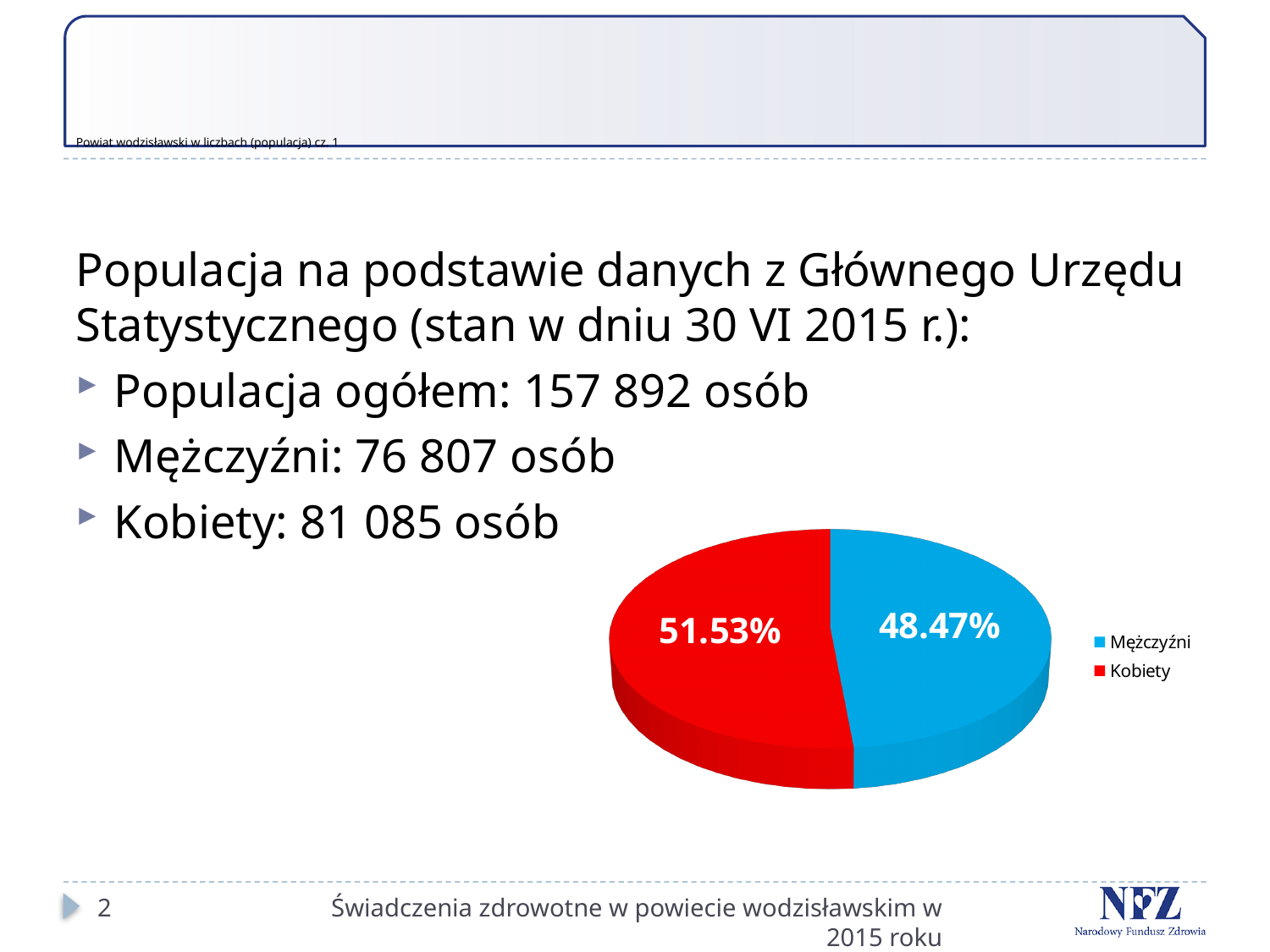
Which slice of the pie is the largest? Kobiety Which is larger, the Kobiety slice or the Mężczyźni slice? Kobiety What colour is the Kobiety slice in the pie chart? red What is the difference in percentage points between the Kobiety and Mężczyźni slices? 3.06 What colour is the Mężczyźni slice in the pie chart? blue How many slices does the pie chart have? 2 What share of the pie does the Mężczyźni slice represent? 48.47% How many entries does the legend list? 2 What share of the pie does the Kobiety slice represent? 51.53% What kind of chart is shown on the slide? pie chart Which slice of the pie is the smallest? Mężczyźni